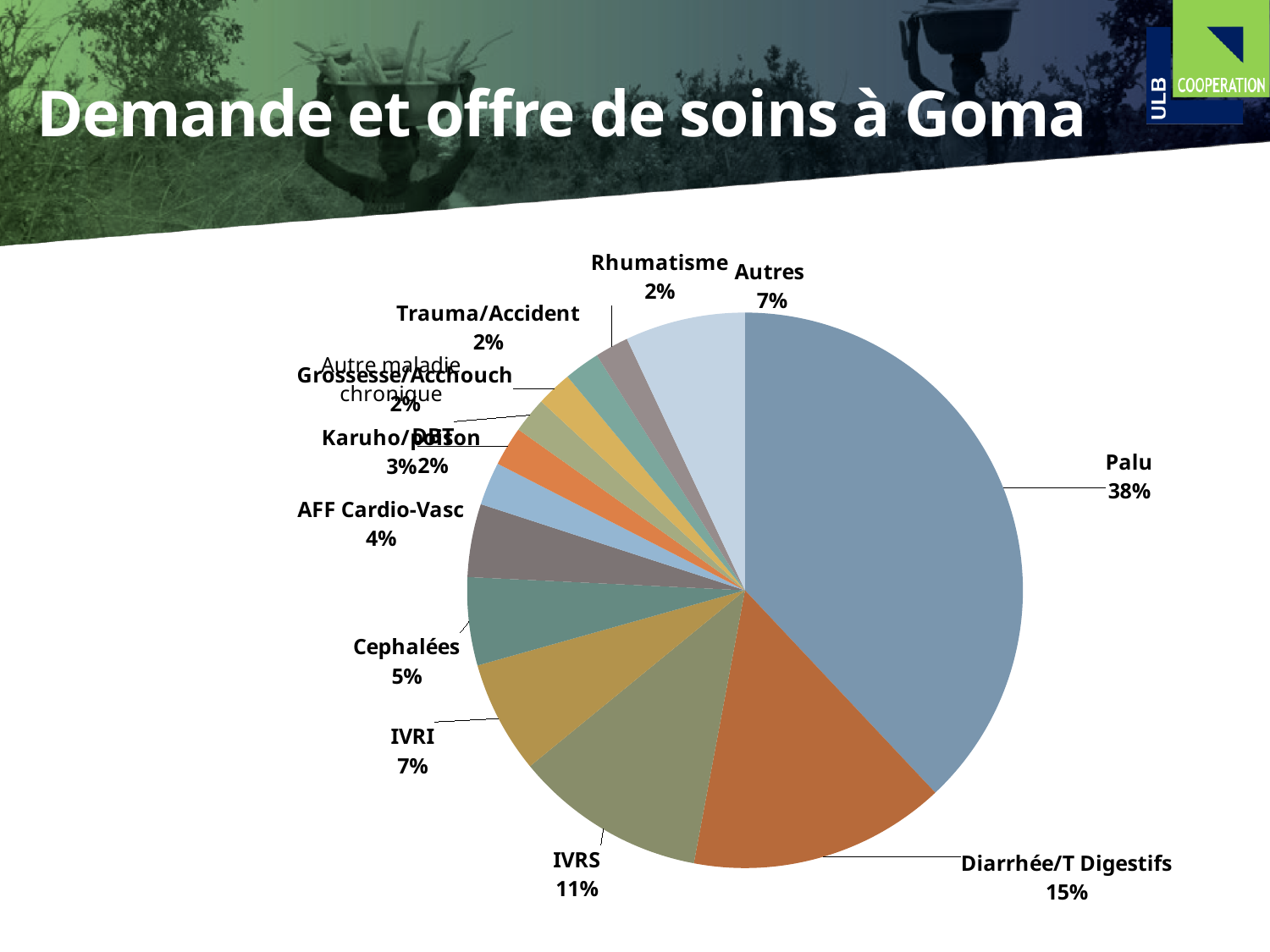
What is the value shown for Cephalées? 5% What is the value shown for Diarrhée/T Digestifs? 15% Which is larger, IVRS or IVRI? IVRS Which category has the largest slice of the pie? Palu What is the value shown for AFF Cardio-Vasc? 4% What is the difference in percentage points between Palu and Diarrhée/T Digestifs? 23 What is the value shown for IVRS? 11% What is the value shown for IVRI? 7% What kind of chart is shown on the slide? pie chart What is the value shown for Autres? 7% What is the value shown for Rhumatisme? 2% What share of the pie does Palu represent? 38%